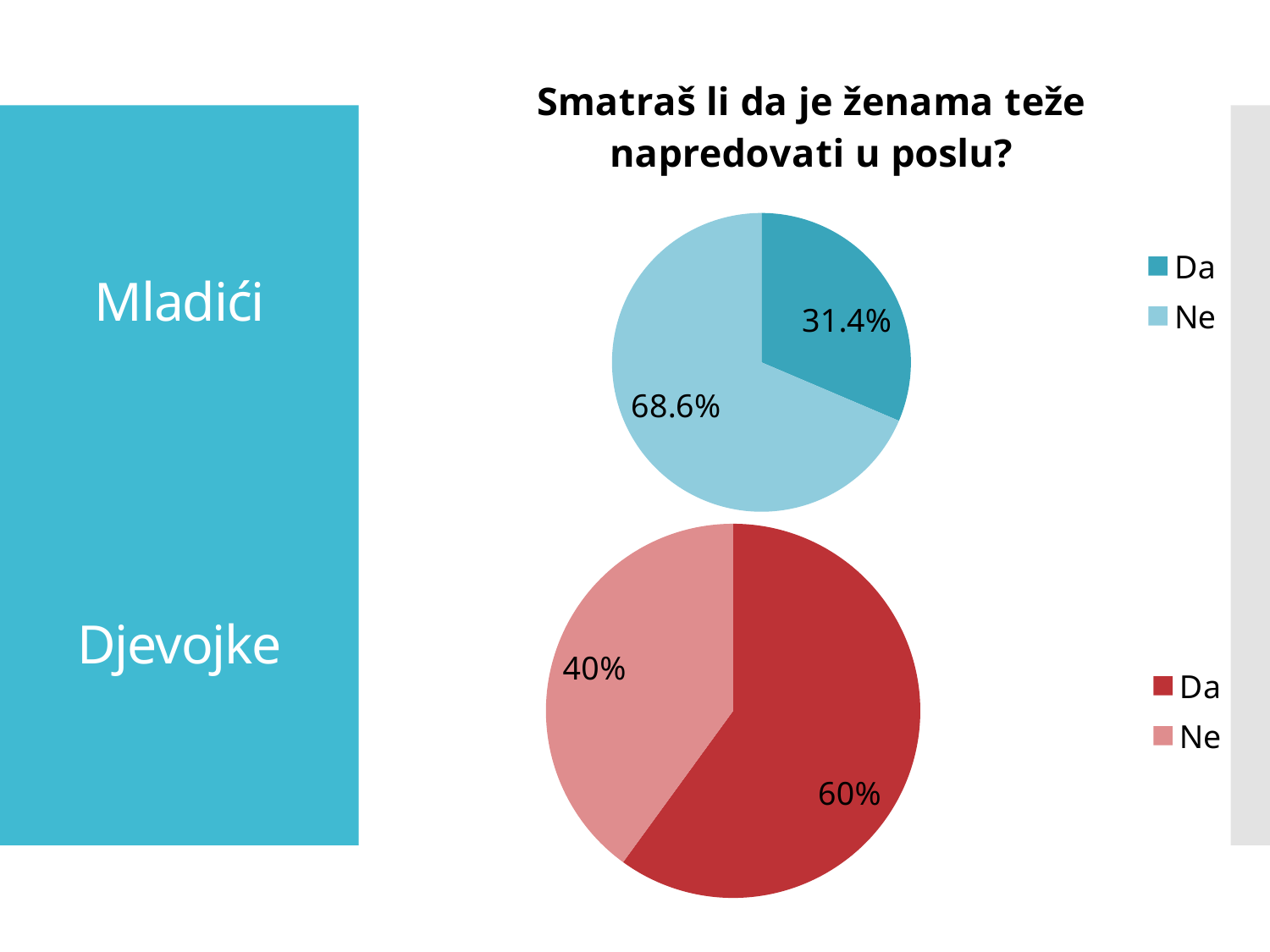
In the top pie chart (Mladići), what share of respondents answered "Ne"? 68.6% In the top pie chart (Mladići), what is the difference between the "Ne" and "Da" shares? 37.2% In the top pie chart (Mladići), which answer has the larger slice? Ne Which is larger: the "Da" share in the top pie chart (Mladići) or the "Da" share in the bottom pie chart (Djevojke)? Djevojke In the bottom pie chart (Djevojke), what is the difference between the "Da" and "Ne" shares? 20% What type of chart is used on this slide? Pie chart In the top pie chart (Mladići), what share of respondents answered "Da"? 31.4% In the bottom pie chart (Djevojke), what share of respondents answered "Ne"? 40% In the bottom pie chart (Djevojke), what share of respondents answered "Da"? 60% How many slices does the bottom pie chart (Djevojke) have? 2 In the bottom pie chart (Djevojke), which answer has the smaller slice? Ne What is the title shown above the charts? Smatraš li da je ženama teže napredovati u poslu?